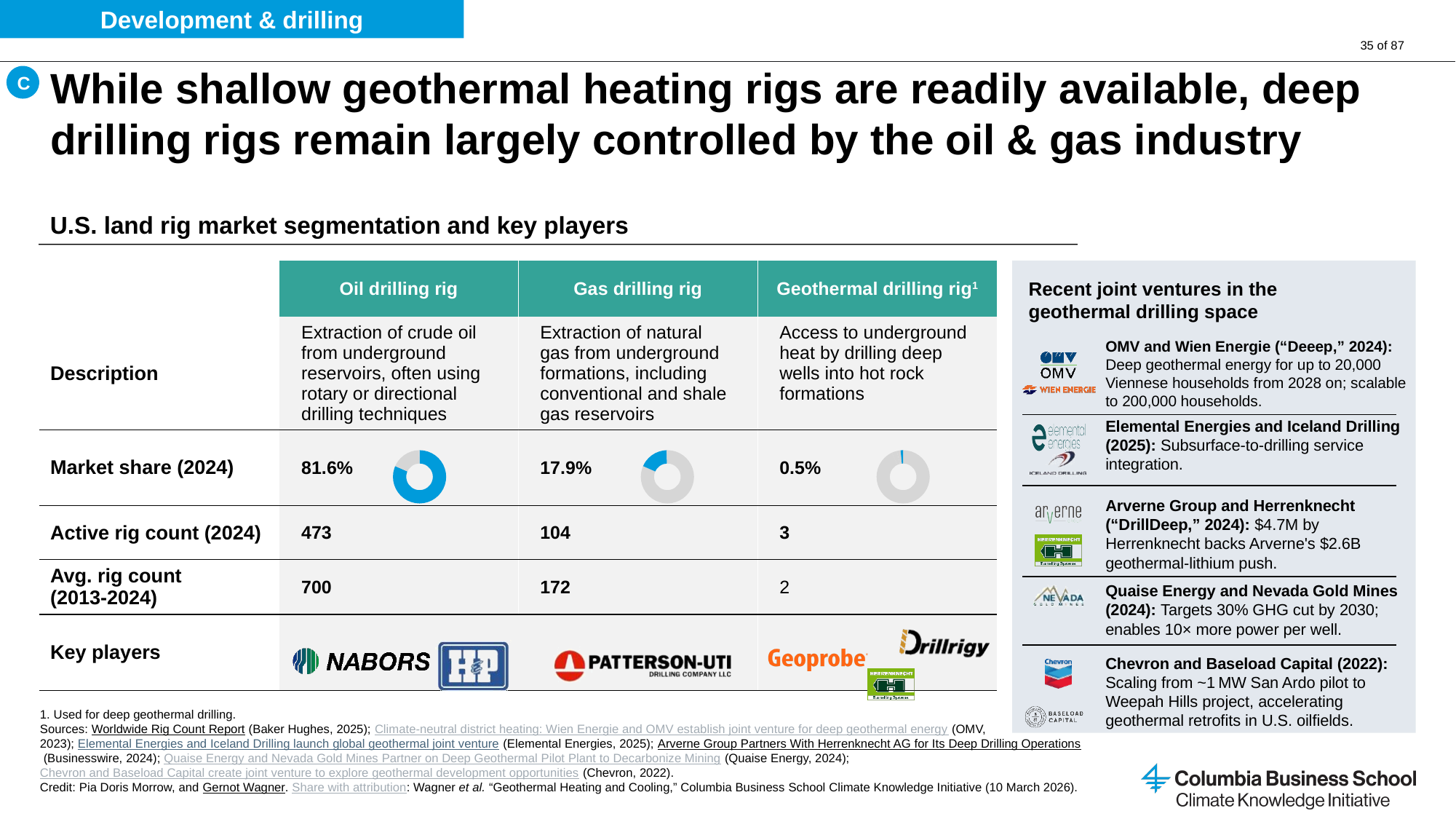
In the Market share (2024) row, what market share is shown for the gas drilling rig? 17.9% Among the three market share donut charts, which rig type has the largest 2024 market share? Oil drilling rig What is the difference in 2024 market share between the gas drilling rig and the geothermal drilling rig? 17.4% In the Market share (2024) row, what market share is shown for the geothermal drilling rig? 0.5% In the Market share (2024) row, what market share is shown for the oil drilling rig? 81.6% What is the combined 2024 market share of the oil, gas and geothermal drilling rigs shown in the donut charts? 100% Among the three market share donut charts, which rig type has the smallest 2024 market share? Geothermal drilling rig What kind of chart is used to show the 2024 market share for each rig type? Donut chart Which has a larger 2024 market share, the gas drilling rig or the geothermal drilling rig? Gas drilling rig What is the difference in 2024 market share between the oil drilling rig and the gas drilling rig? 63.7% What colour is the filled slice in the market share donut charts? Blue How many market share donut charts are shown in the Market share (2024) row? 3